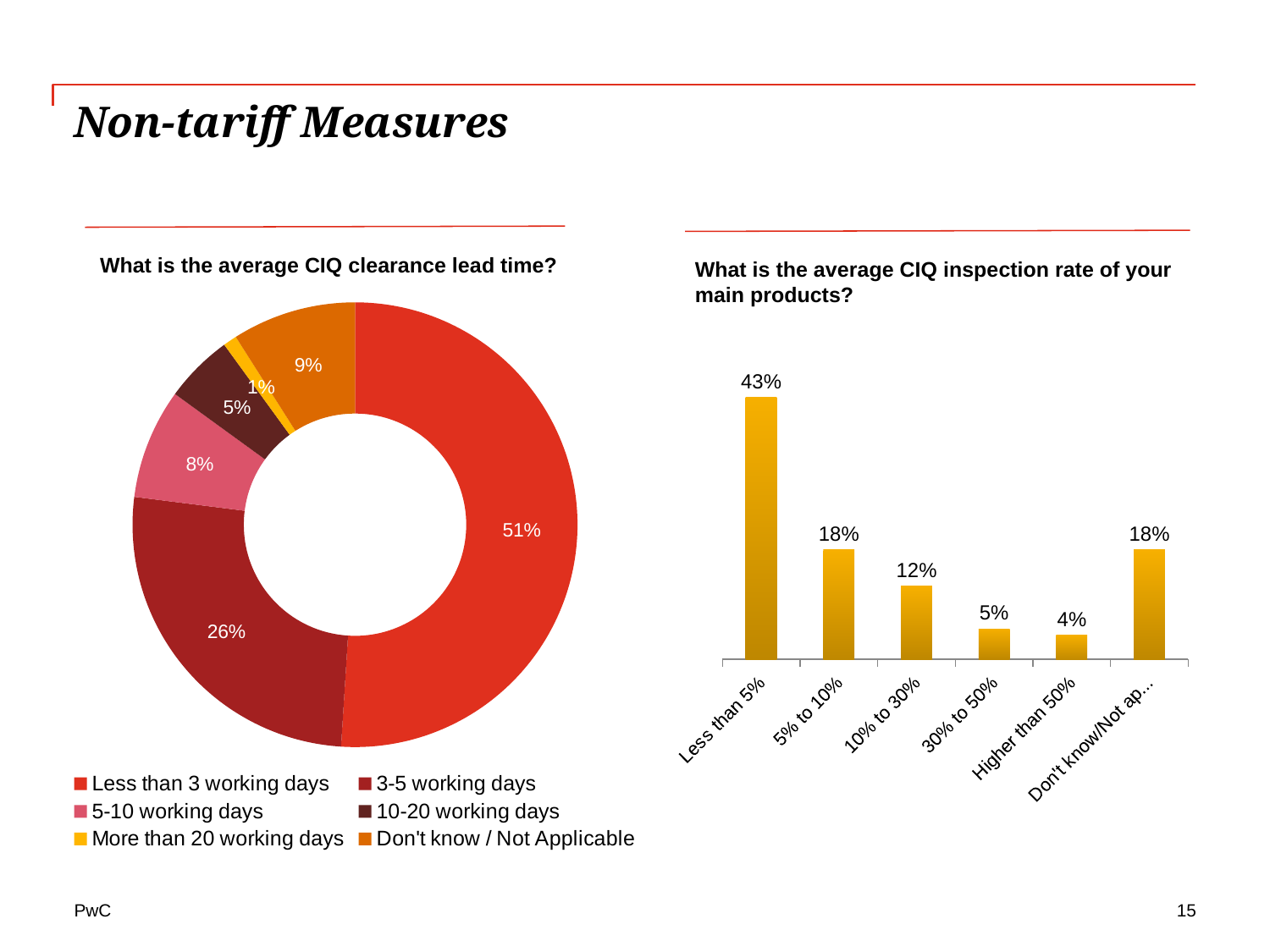
In the chart titled 'What is the average CIQ inspection rate of your main products?', what is the value for '10% to 30%'? 12% In the chart titled 'What is the average CIQ inspection rate of your main products?', what is the difference between 'Less than 5%' and '5% to 10%'? 25 percentage points In the chart titled 'What is the average CIQ clearance lead time?', which category has the smallest share? More than 20 working days What type of chart is the one titled 'What is the average CIQ clearance lead time?'? Doughnut chart In the chart titled 'What is the average CIQ inspection rate of your main products?', which is larger: '5% to 10%' or '30% to 50%'? 5% to 10% In the chart titled 'What is the average CIQ clearance lead time?', what percentage corresponds to '3-5 working days'? 26% In the chart titled 'What is the average CIQ clearance lead time?', how many categories does the legend list? 6 What type of chart is the one titled 'What is the average CIQ inspection rate of your main products?'? Bar chart In the chart titled 'What is the average CIQ inspection rate of your main products?', what is the value for 'Less than 5%'? 43% In the chart titled 'What is the average CIQ clearance lead time?', what share of respondents answered 'Less than 3 working days'? 51% In the chart titled 'What is the average CIQ clearance lead time?', what is the difference in percentage points between '5-10 working days' and '10-20 working days'? 3 percentage points In the chart titled 'What is the average CIQ inspection rate of your main products?', which category has the lowest value? Higher than 50%